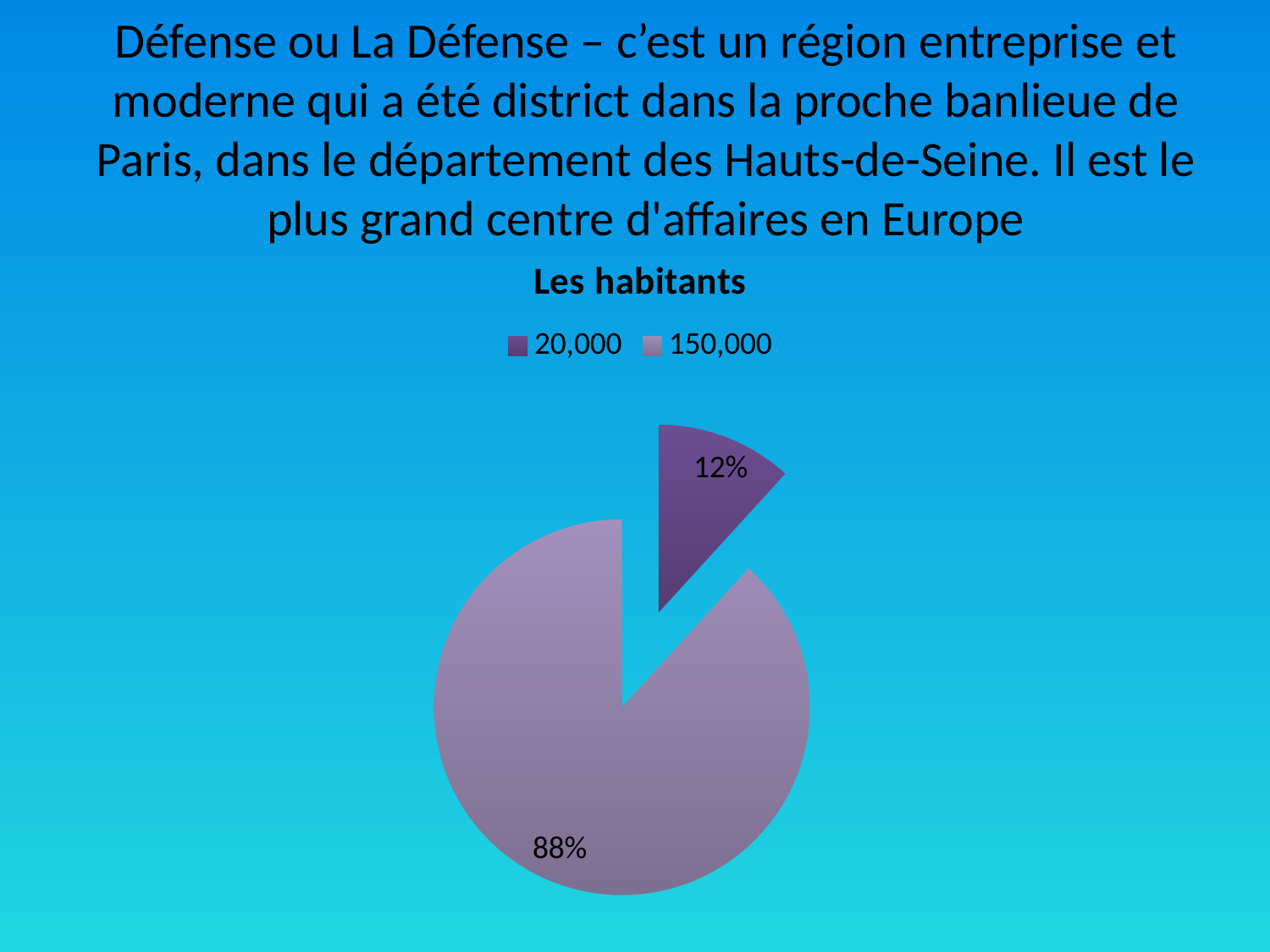
What kind of chart is shown on the slide? pie chart Which slice is the smallest in the pie chart? 20,000 How many slices does the pie chart have? 2 What percentage of the pie does the 20,000 slice represent? 12% How many entries does the legend list? 2 Which slice is larger, 20,000 or 150,000? 150,000 Which legend entry is shown in the darker purple colour? 20,000 What is the difference in percentage points between the 150,000 slice and the 20,000 slice? 76% Which slice is the largest in the pie chart? 150,000 What is the title of the chart? Les habitants What percentage of the pie does the 150,000 slice represent? 88%